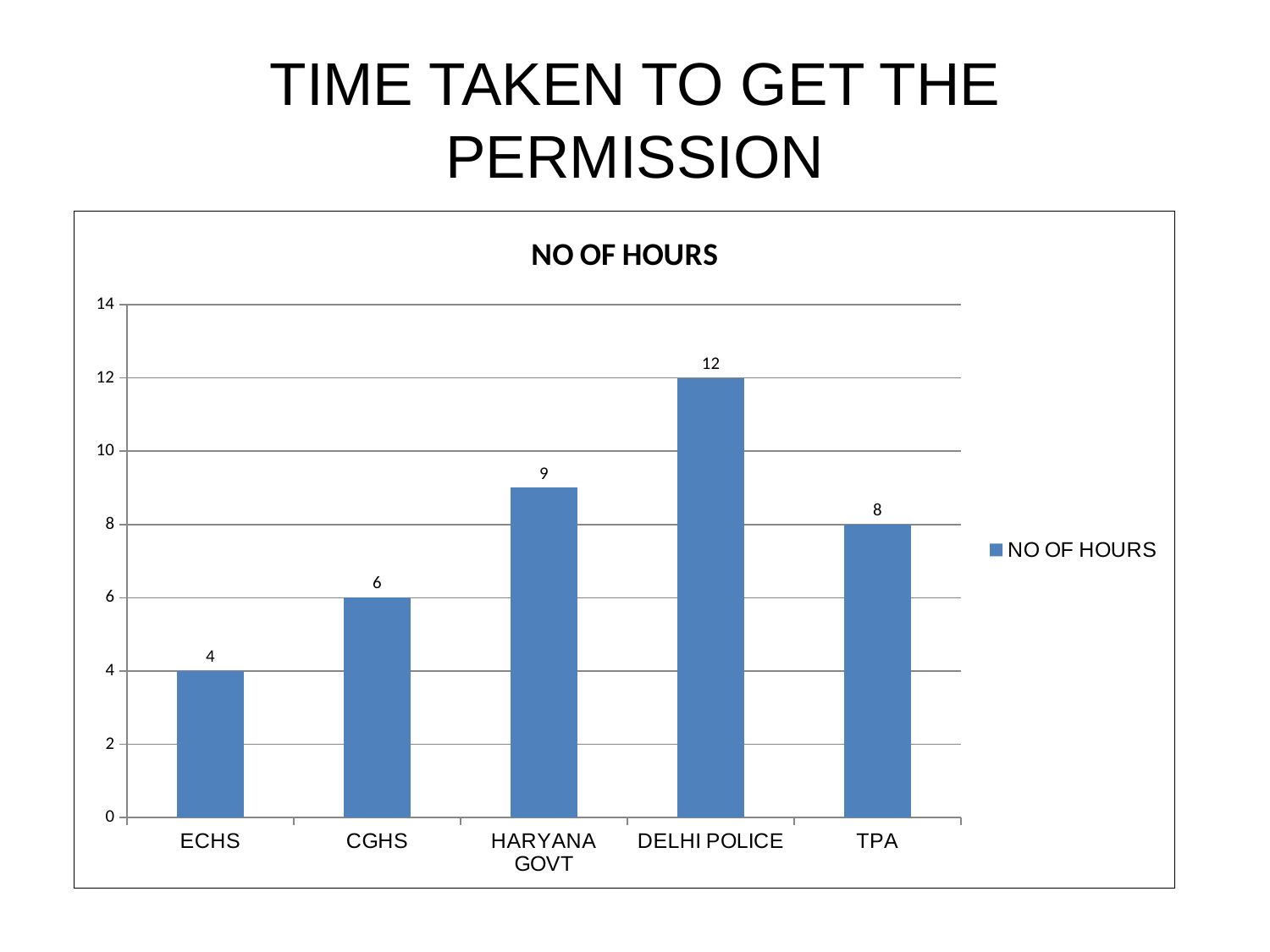
What is the title of the chart? NO OF HOURS How many categories are shown on the x axis? 5 Is the value for HARYANA GOVT greater or less than 10? less What is the value for DELHI POLICE? 12 What is the difference between the values for DELHI POLICE and TPA? 4 What is the value for HARYANA GOVT? 9 How many series does the legend list? 1 What is the value for ECHS? 4 Which category has the lowest number of hours? ECHS Which category has the highest number of hours? DELHI POLICE What kind of chart is shown on the slide? bar chart Which is larger, the value for CGHS or the value for TPA? TPA